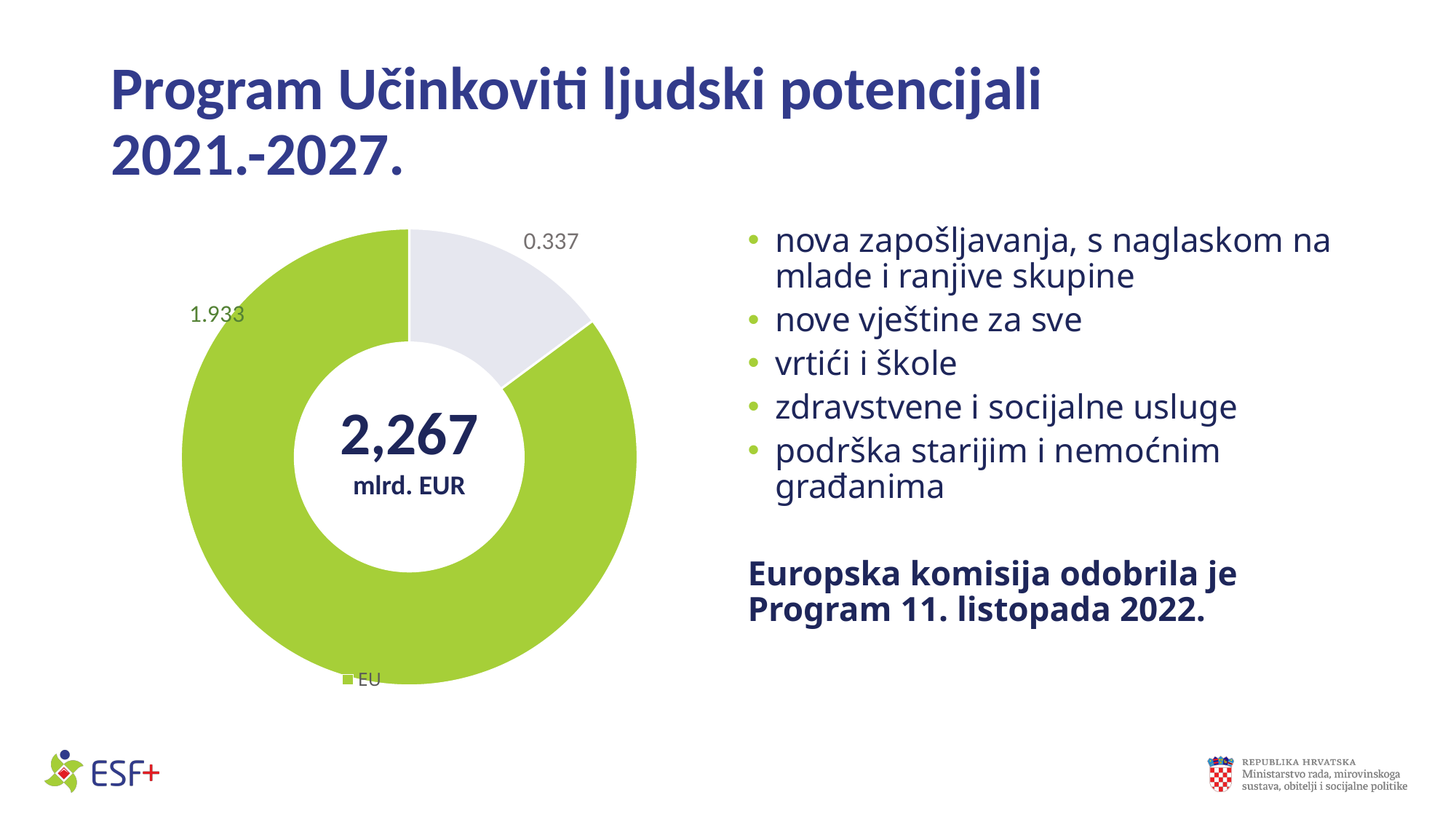
Which slice of the doughnut chart is the largest? EU What value is labelled on the grey slice of the doughnut chart? 0.337 Which slice of the doughnut chart is the smallest? the grey slice (0.337) What kind of chart is shown on the slide? doughnut chart What value is shown for the EU slice of the doughnut chart? 1.933 What is the difference between the EU slice value (1.933) and the grey slice value (0.337)? 1.596 Is the EU slice larger or smaller than the grey slice? larger What colour is the EU slice of the doughnut chart? green How many slices does the doughnut chart have? 2 What text is displayed in the centre of the doughnut chart? 2,267 mlrd. EUR How many entries does the chart legend list? 1